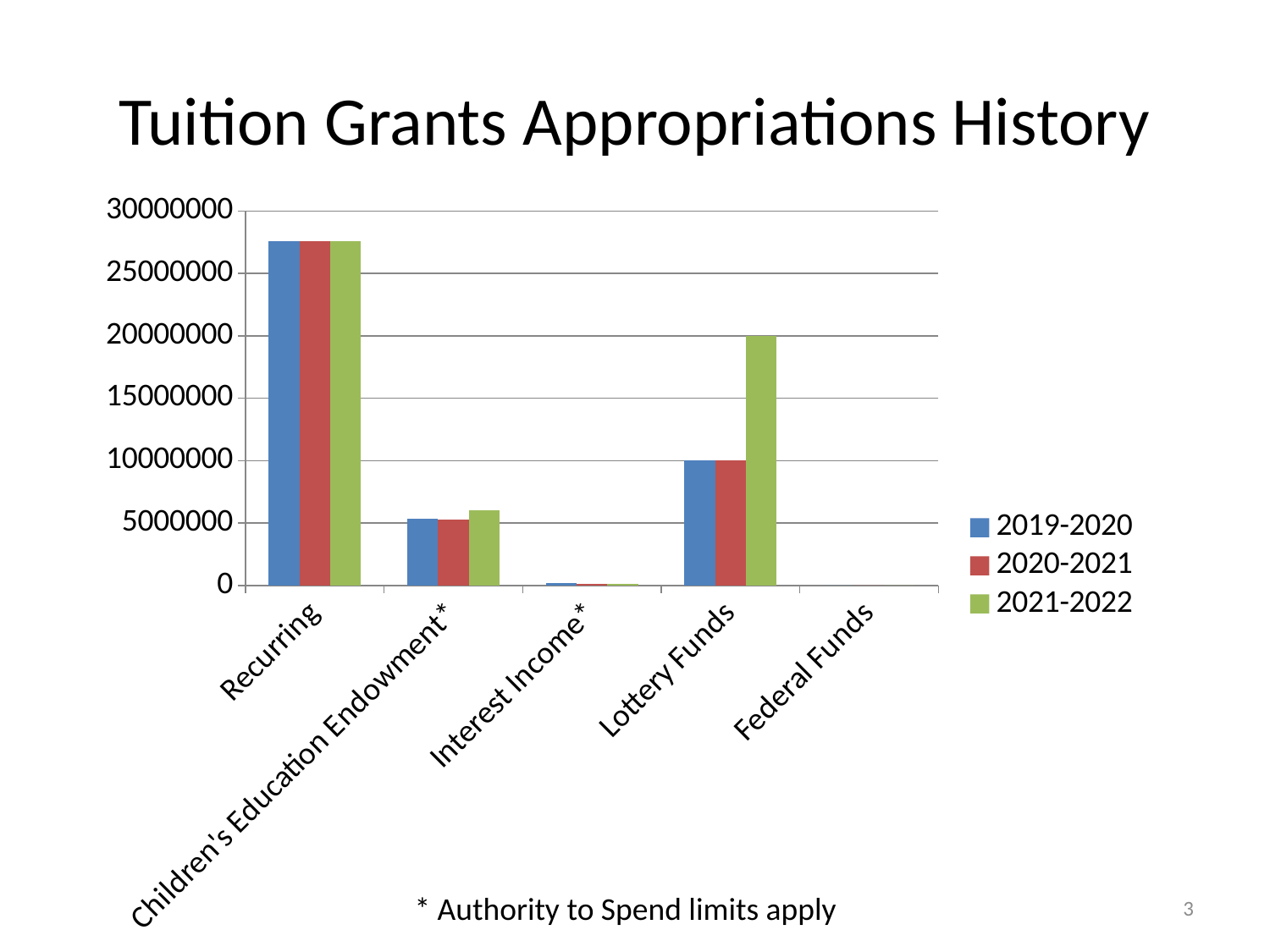
How many categories are shown on the x axis? 5 What is the value for Lottery Funds in 2019-2020? 10000000 How many series does the legend list? 3 Which category has the lowest value for the 2021-2022 series? Federal Funds What kind of chart is shown on the slide? bar chart Is the value for Interest Income* in 2019-2020 greater or less than 5000000? less For Lottery Funds, which series has the larger value: 2020-2021 or 2021-2022? 2021-2022 Which category has the highest value for the 2019-2020 series? Recurring Is the value for Recurring in 2020-2021 greater or less than 25000000? greater Is the value for Children's Education Endowment* in 2021-2022 greater or less than 5000000? greater What is the title of the chart? Tuition Grants Appropriations History What is the value for Lottery Funds in 2021-2022? 20000000